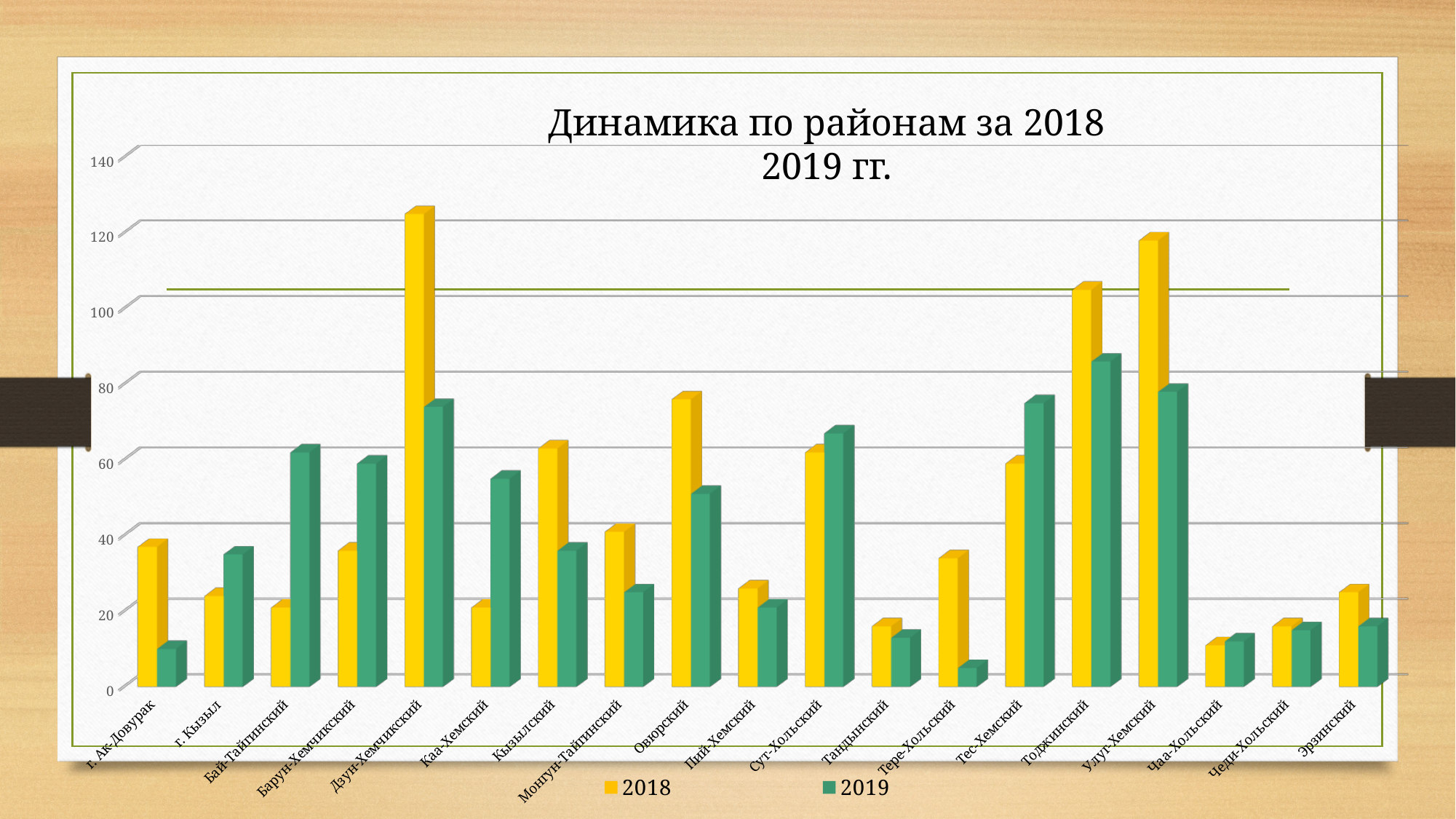
Which district has the highest value for 2019? Тоджинский For Бай-Тайгинский, which year has the larger value, 2018 or 2019? 2019 Which district has the highest value for 2018? Дзун-Хемчикский Which colour represents the 2019 series in the legend? Green How many series does the legend list? 2 Which district has the lowest value for 2018? Чаа-Хольский How many districts (categories) are shown on the x axis? 19 Is the 2019 value for Тере-Хольский greater or less than 20? less For г. Ак-Довурак, which year has the larger value, 2018 or 2019? 2018 Is the 2018 value for Улуг-Хемский greater or less than 100? greater Which district has the lowest value for 2019? Тере-Хольский What kind of chart is shown on the slide? Bar chart